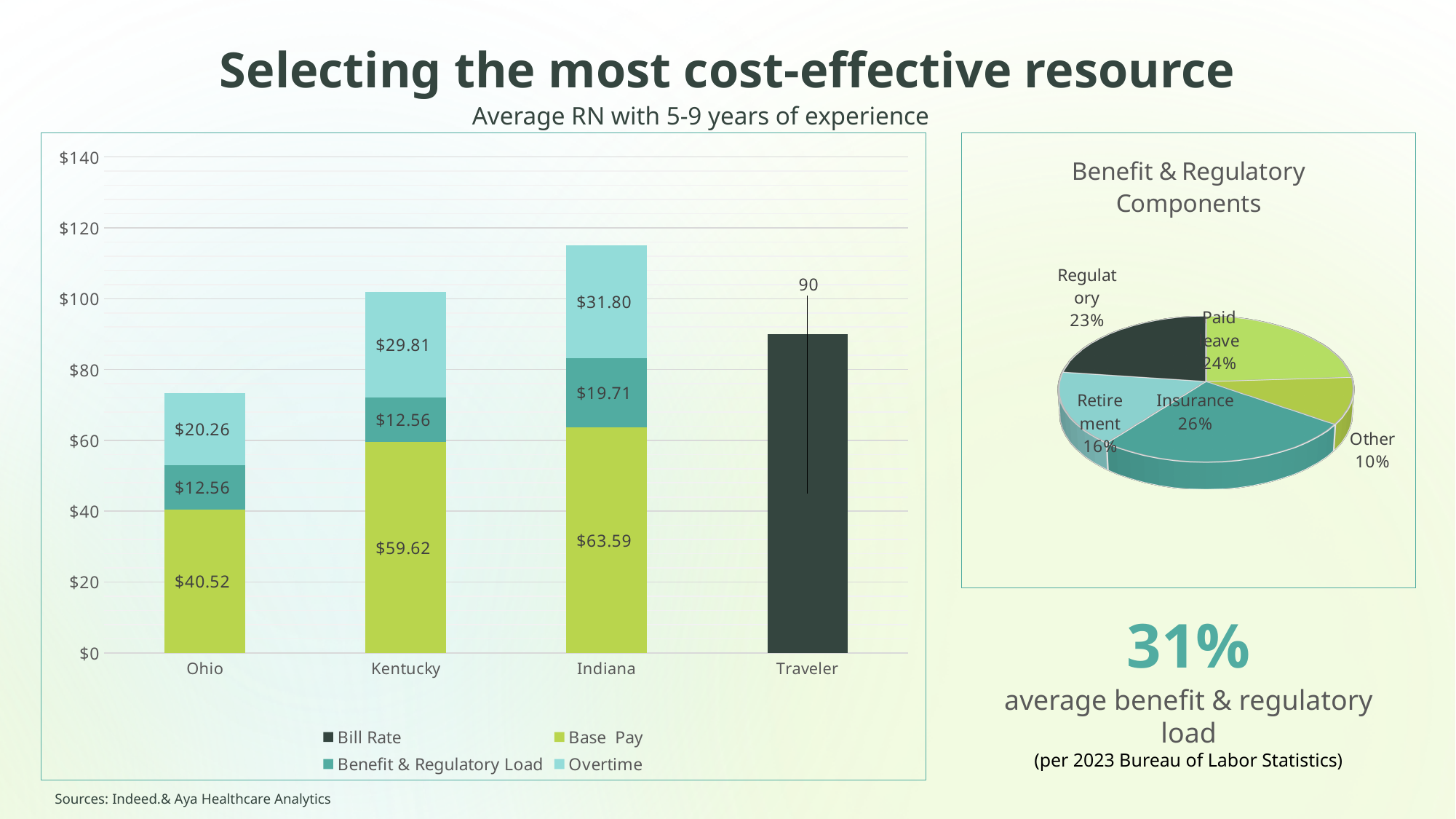
In the bar chart, what is the Base Pay value for Ohio? $40.52 In the bar chart, what is the difference between the Base Pay for Indiana and the Base Pay for Ohio? $23.07 In the bar chart, what is the Bill Rate value shown for Traveler? 90 In the bar chart, which state has the lowest Overtime value? Ohio In the bar chart, what is the Overtime value for Kentucky? $29.81 How many series does the legend of the bar chart list? 4 In the bar chart, which state has the highest Base Pay? Indiana In the bar chart, what is the total of the stacked bar for Ohio? $73.34 In the Benefit & Regulatory Components pie chart, what share does Retirement have? 16% In the bar chart, is the total height of the Indiana bar greater or less than $100? greater In the bar chart, which is larger: the Benefit & Regulatory Load for Kentucky or for Indiana? Indiana In the Benefit & Regulatory Components pie chart, which component has the largest share? Insurance